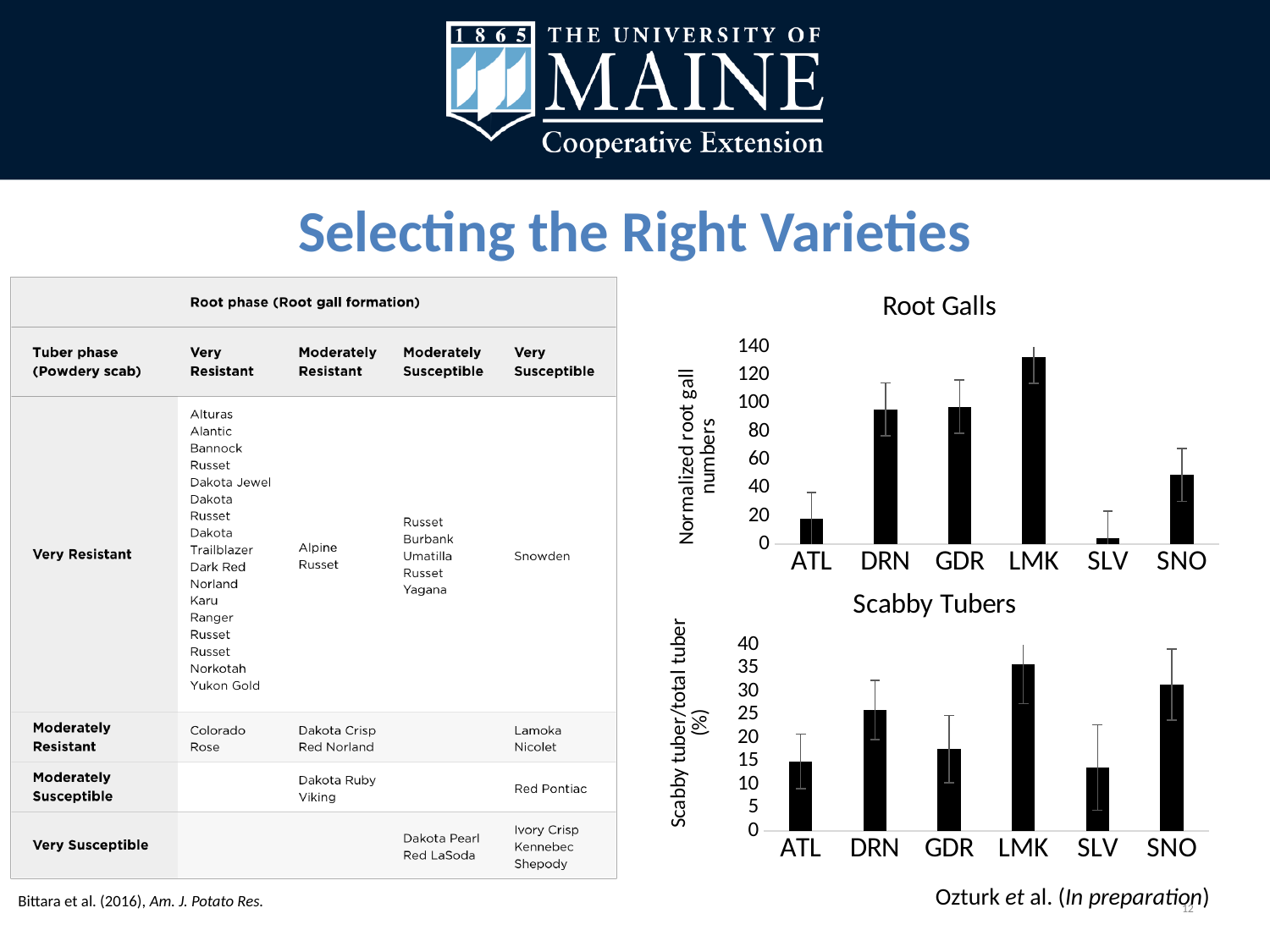
In the Scabby Tubers chart, which is larger, the value for DRN or the value for GDR? DRN In the Root Galls chart, which variety has the lowest normalized root gall number? SLV In the Root Galls chart, is the value for SNO greater or less than 60? less In the Root Galls chart, which is larger, the value for DRN or the value for SLV? DRN In the Scabby Tubers chart, which variety has the highest percentage of scabby tubers? LMK In the Root Galls chart, which variety has the highest normalized root gall number? LMK In the Scabby Tubers chart, is the value for LMK greater or less than 30? greater What is the y-axis label of the Scabby Tubers chart? Scabby tuber/total tuber (%) In the Root Galls chart, is the value for LMK greater or less than 120? greater How many varieties are shown on the x axis of the Root Galls chart? 6 What kind of chart is the Scabby Tubers chart? bar chart